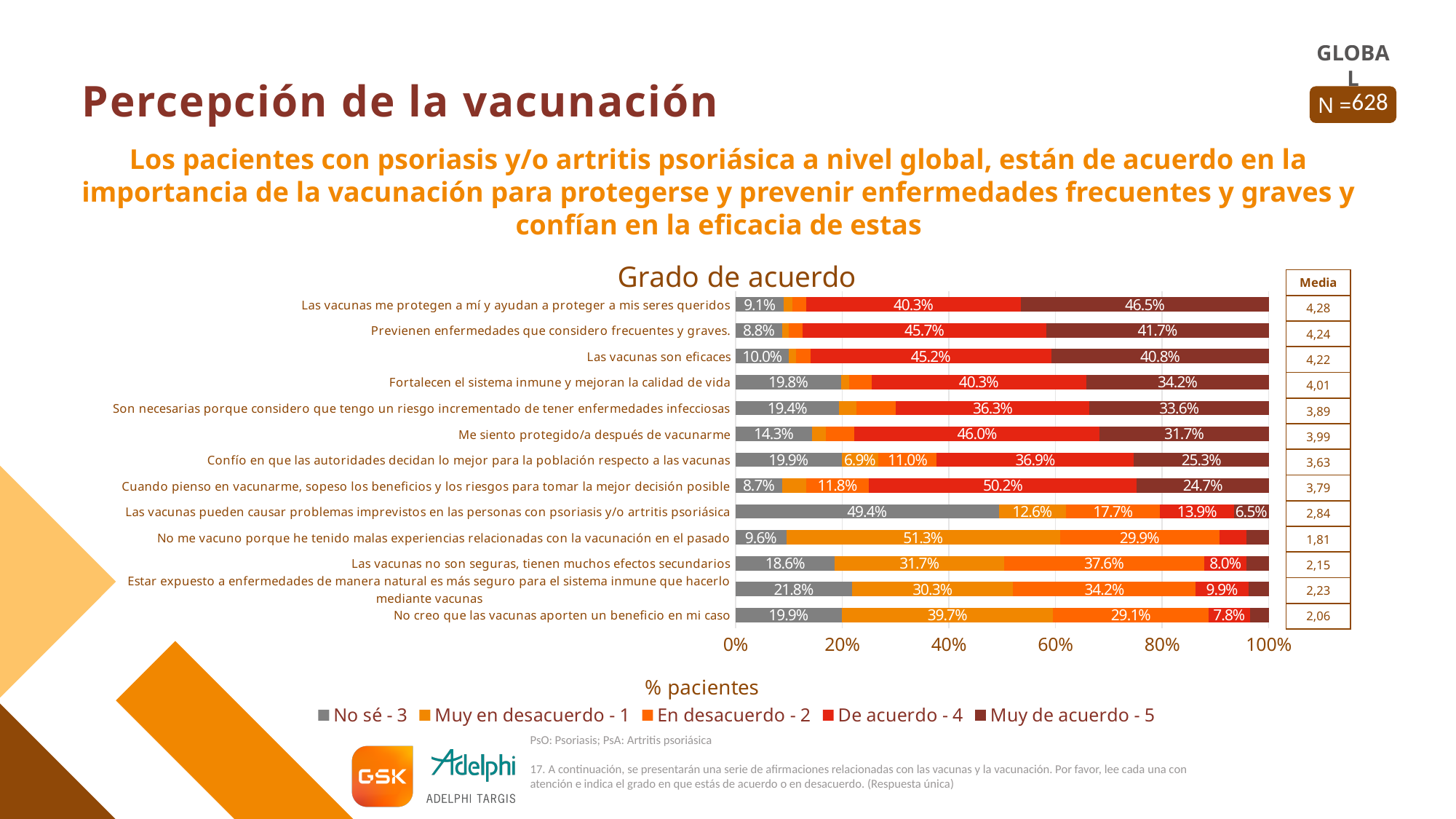
How many series does the legend of the "Grado de acuerdo" chart list? 5 Which statement has the highest "Muy de acuerdo - 5" value? Las vacunas me protegen a mí y ayudan a proteger a mis seres queridos What is the x-axis title of the "Grado de acuerdo" chart? % pacientes What is the "Muy de acuerdo - 5" value for "Las vacunas me protegen a mí y ayudan a proteger a mis seres queridos"? 46.5% What is the "En desacuerdo - 2" value for "Confío en que las autoridades decidan lo mejor para la población respecto a las vacunas"? 11.0% What kind of chart is shown under the title "Grado de acuerdo"? Stacked bar chart What is the "De acuerdo - 4" value for "Cuando pienso en vacunarme, sopeso los beneficios y los riesgos para tomar la mejor decisión posible"? 50.2% What is the difference between the "Muy de acuerdo - 5" value for "Las vacunas me protegen a mí y ayudan a proteger a mis seres queridos" and for "Las vacunas son eficaces"? 5.7 percentage points Which statement has the lowest "No sé - 3" value? Cuando pienso en vacunarme, sopeso los beneficios y los riesgos para tomar la mejor decisión posible What is the "No sé - 3" value for "Las vacunas pueden causar problemas imprevistos en las personas con psoriasis y/o artritis psoriásica"? 49.4% Which is larger: the "Muy en desacuerdo - 1" value for "No me vacuno porque he tenido malas experiencias relacionadas con la vacunación en el pasado" or for "Las vacunas no son seguras, tienen muchos efectos secundarios"? No me vacuno porque he tenido malas experiencias relacionadas con la vacunación en el pasado How many statements (categories) are plotted in the "Grado de acuerdo" chart? 13